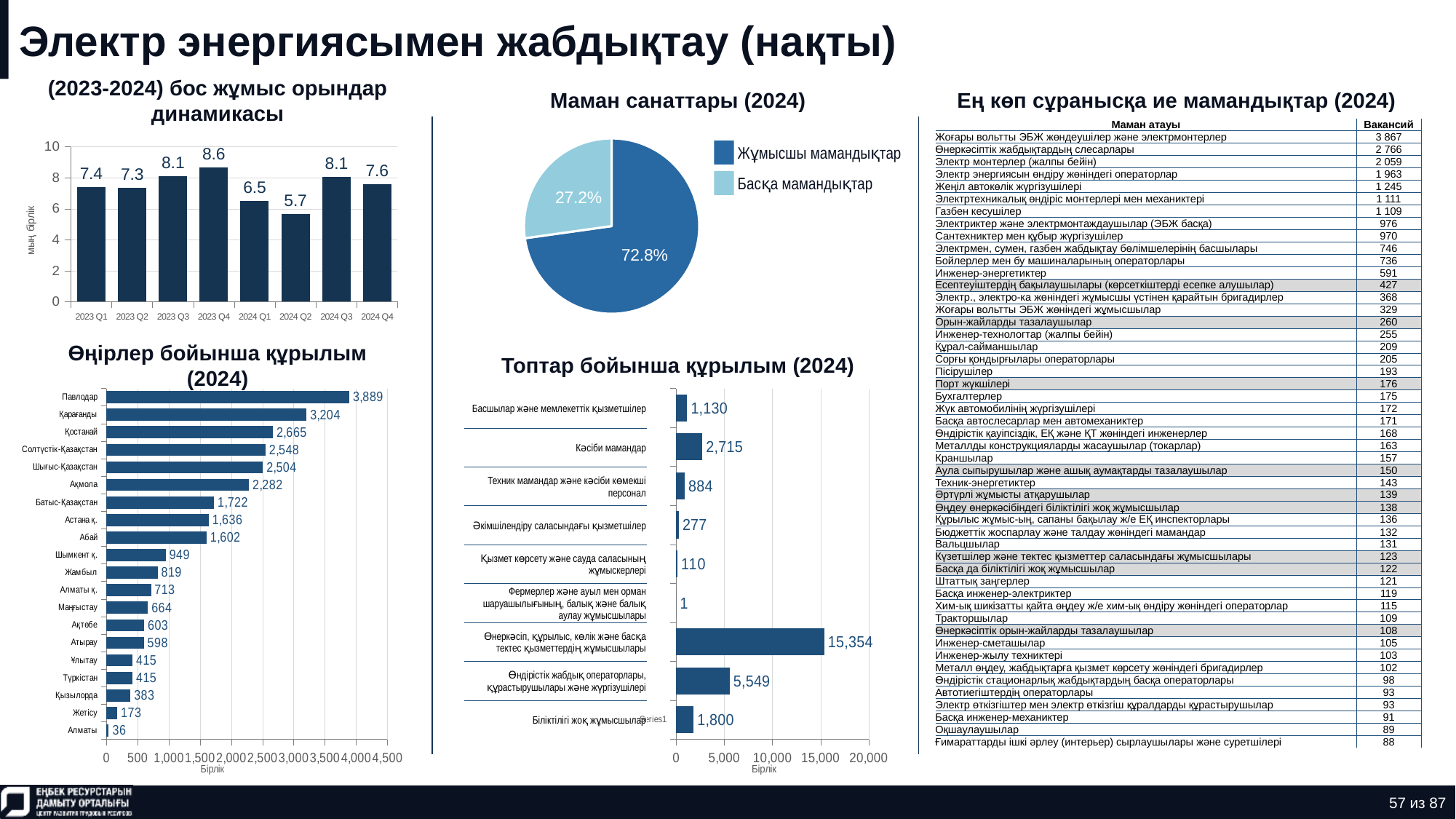
On the 'Топтар бойынша құрылым (2024)' chart, which is larger: 'Біліктілігі жоқ жұмысшылар' or 'Басшылар және мемлекеттік қызметшілер'? Біліктілігі жоқ жұмысшылар On the 'Өңірлер бойынша құрылым (2024)' chart, what is the value for Ақмола? 2,282 What kind of chart is 'Маман санаттары (2024)'? Pie chart On the 'Маман санаттары (2024)' chart, what share does 'Жұмысшы мамандықтар' have? 72.8% On the 'Өңірлер бойынша құрылым (2024)' chart, which region has the highest value? Павлодар What kind of chart is 'Топтар бойынша құрылым (2024)'? Bar chart On the '(2023-2024) бос жұмыс орындар динамикасы' chart, what is the difference between 2023 Q4 and 2024 Q2? 2.9 On the '(2023-2024) бос жұмыс орындар динамикасы' chart, which quarter has the lowest value? 2024 Q2 On the 'Өңірлер бойынша құрылым (2024)' chart, how many regions are listed? 20 On the 'Топтар бойынша құрылым (2024)' chart, what is the value for 'Кәсіби мамандар'? 2,715 On the '(2023-2024) бос жұмыс орындар динамикасы' chart, how many quarters are plotted? 8 On the '(2023-2024) бос жұмыс орындар динамикасы' chart, what is the value for 2023 Q4? 8.6